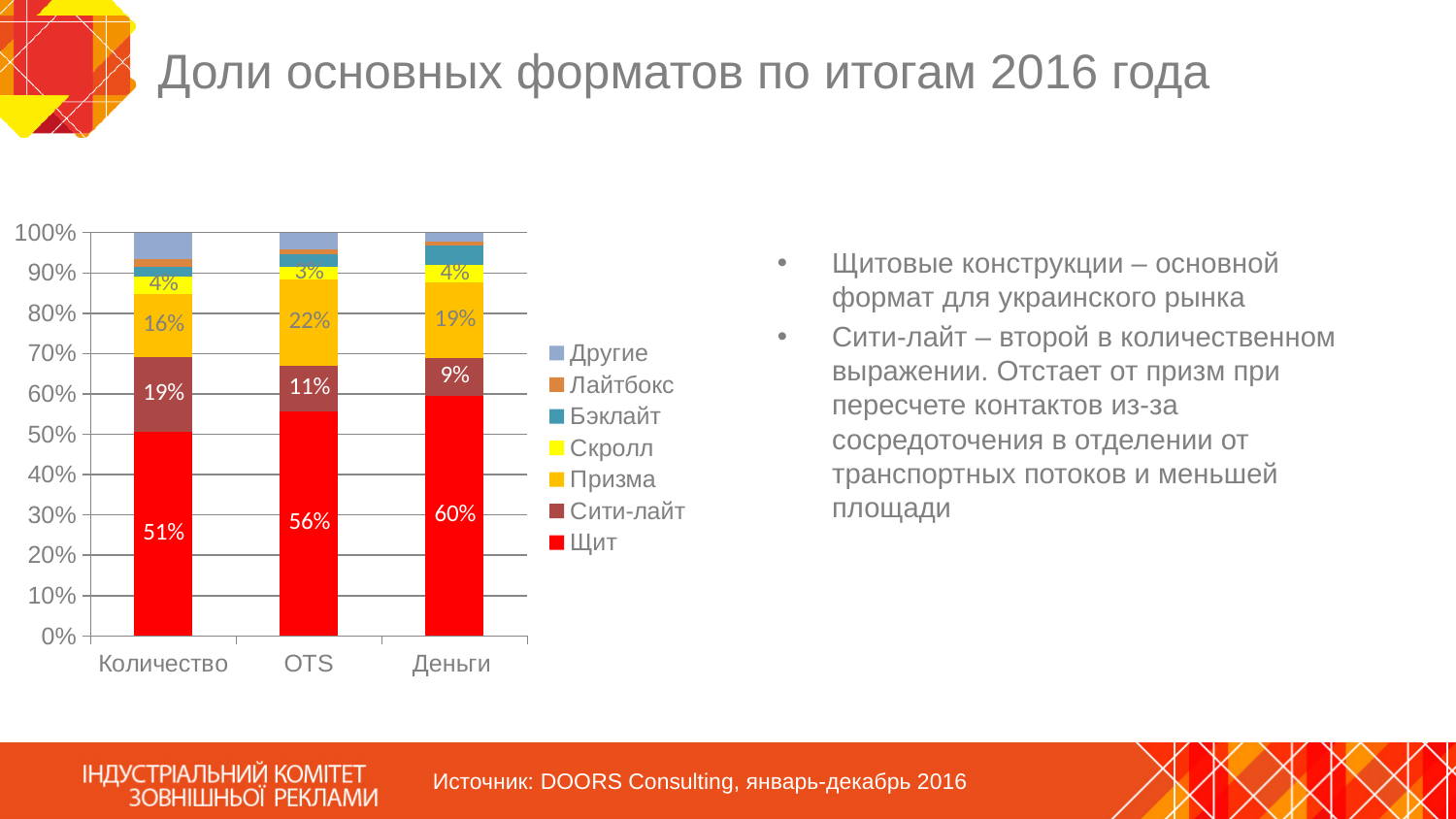
What is the value for Призма in the Деньги bar? 19% In which category is the Сити-лайт share lowest? Деньги In which category is the Щит share highest? Деньги What is the value for Сити-лайт in the OTS bar? 11% What kind of chart is shown on the slide? Stacked bar chart What is the title of the slide? Доли основных форматов по итогам 2016 года Which is larger: the Призма share in OTS or in Количество? OTS What is the value for Скролл in the OTS bar? 3% How many categories are shown on the x axis? 3 How many series does the legend list? 7 What is the difference between the Щит share in Деньги and in Количество? 9% What is the value for Щит in the Количество bar? 51%